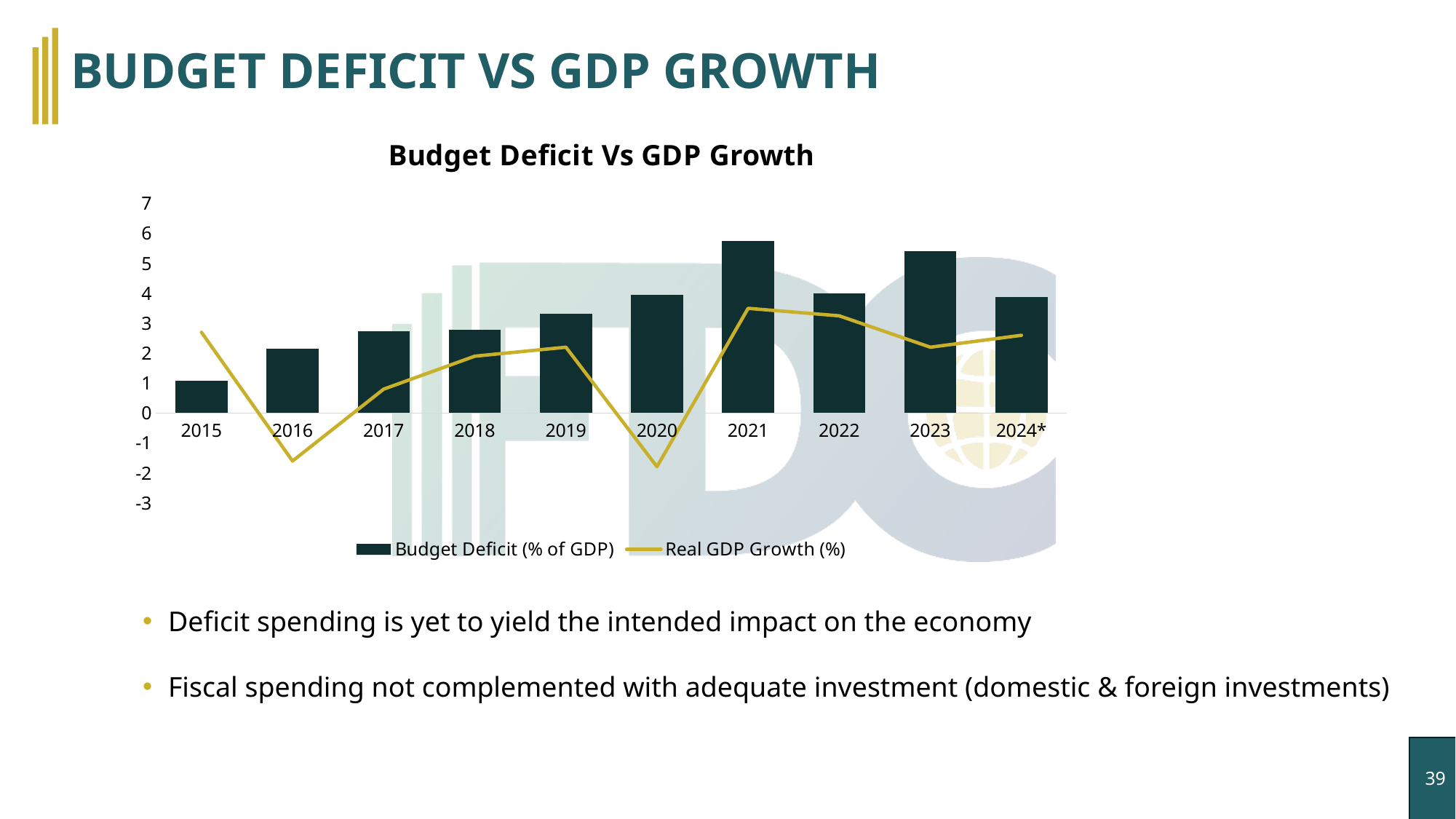
What kind of chart is shown on the slide? A combined bar and line chart Which is larger, the Budget Deficit (% of GDP) bar for 2021 or for 2023? 2021 Does the Budget Deficit (% of GDP) rise or fall from 2015 to 2021? Rise Which year has the lowest Budget Deficit (% of GDP) bar? 2015 Which year has the highest Budget Deficit (% of GDP) bar? 2021 Is the Real GDP Growth (%) for 2016 greater or less than 0? less What is the title of the chart? Budget Deficit Vs GDP Growth How many series does the legend list? 2 Is the Real GDP Growth (%) for 2020 greater or less than -1? less Is the Real GDP Growth (%) for 2021 greater or less than 3? greater How many years are shown on the x axis? 10